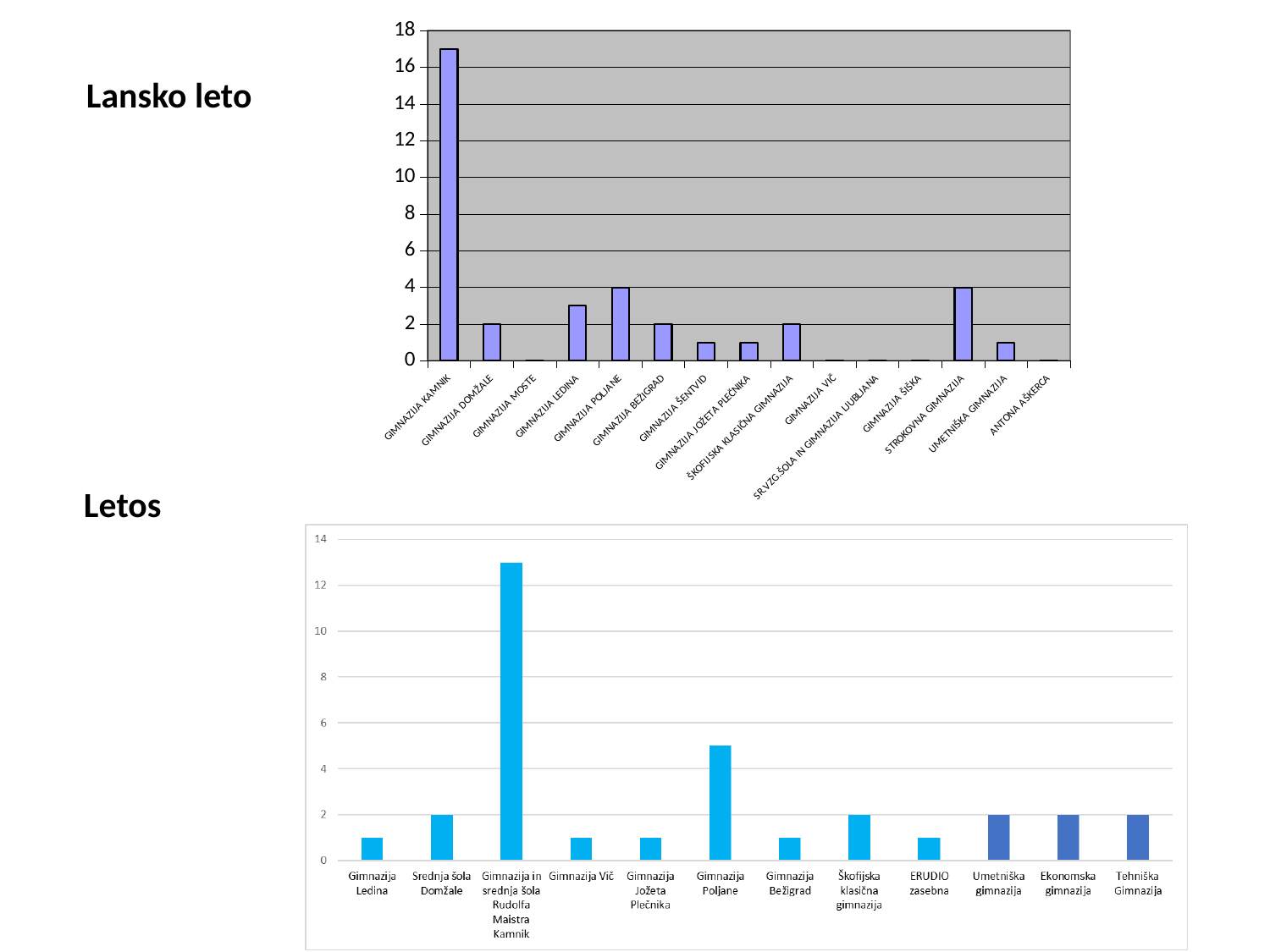
In the 'Lansko leto' chart, which school has the highest value? GIMNAZIJA KAMNIK How many schools are shown on the x axis of the 'Lansko leto' chart? 15 What type of chart is the 'Letos' chart? bar chart In the 'Letos' chart, which school has the highest value? Gimnazija in srednja šola Rudolfa Maistra Kamnik In the 'Letos' chart, is the value for Gimnazija in srednja šola Rudolfa Maistra Kamnik greater or less than 12? greater In the 'Lansko leto' chart, is the value for GIMNAZIJA KAMNIK greater or less than 16? greater In the 'Lansko leto' chart, what is the difference between the values for GIMNAZIJA POLJANE and GIMNAZIJA BEŽIGRAD? 2 In the 'Lansko leto' chart, what is the value for GIMNAZIJA DOMŽALE? 2 How many schools are shown on the x axis of the 'Letos' chart? 12 In the 'Lansko leto' chart, what is the value for GIMNAZIJA POLJANE? 4 In the 'Lansko leto' chart, which is larger, the value for STROKOVNA GIMNAZIJA or the value for ŠKOFIJSKA KLASIČNA GIMNAZIJA? STROKOVNA GIMNAZIJA In the 'Letos' chart, what is the value for Ekonomska gimnazija? 2